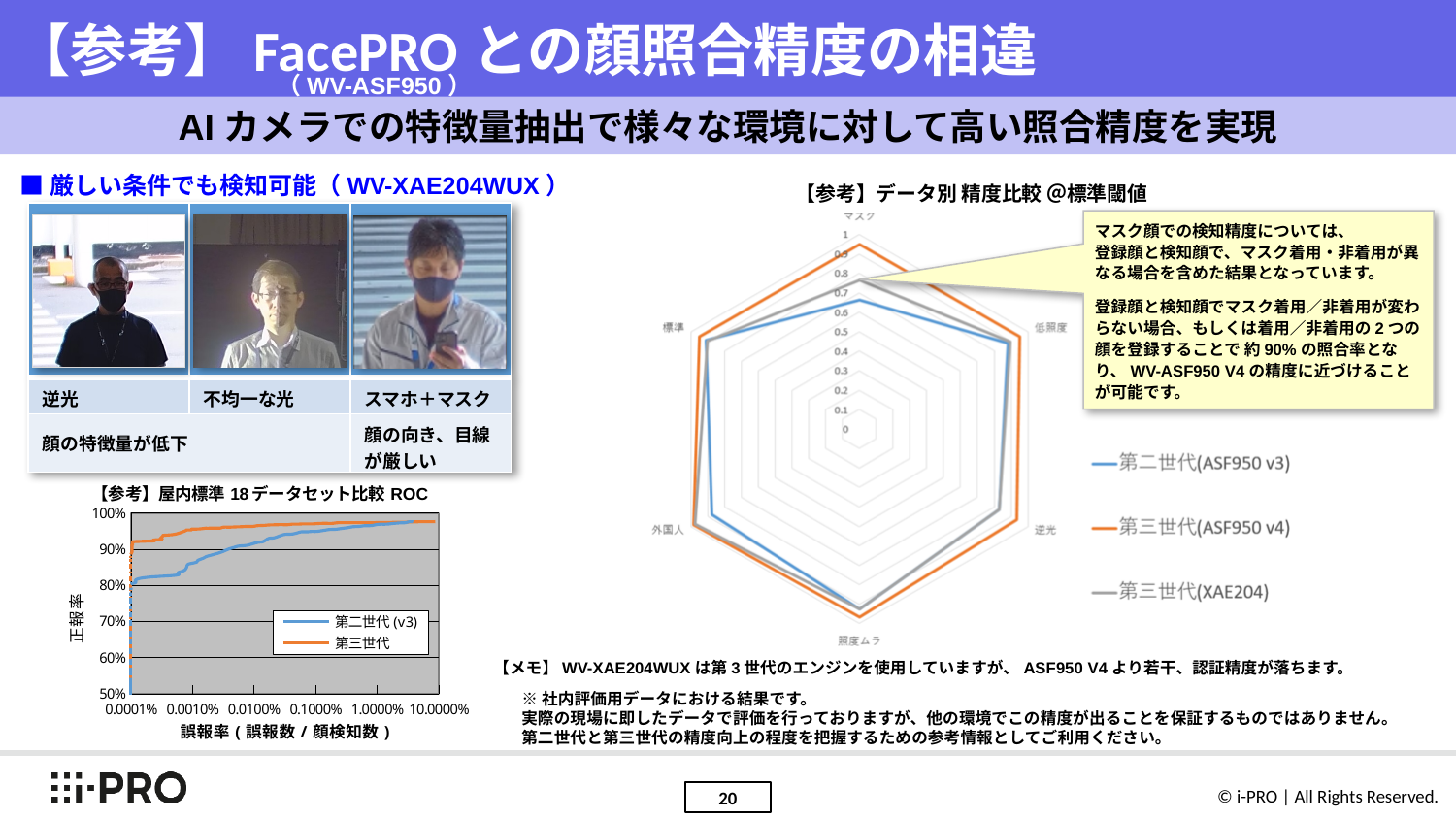
In the radar chart 【参考】データ別 精度比較 @標準閾値, which series has the highest value on the マスク axis? 第三世代(ASF950 v4) What kind of chart is the chart titled 【参考】屋内標準 18データセット比較 ROC? line chart In the radar chart 【参考】データ別 精度比較 @標準閾値, is the value of 第二世代(ASF950 v3) on the マスク axis greater or less than 0.8? less What kind of chart is the chart titled 【参考】データ別 精度比較 @標準閾値? radar chart How many axes (categories) does the radar chart 【参考】データ別 精度比較 @標準閾値 have? 6 In the radar chart 【参考】データ別 精度比較 @標準閾値, how many series does the legend list? 3 What is the label of the vertical axis in the ROC chart 【参考】屋内標準 18データセット比較 ROC? 正報率 In the ROC chart 【参考】屋内標準 18データセット比較 ROC, how many series does the legend list? 2 In the ROC chart 【参考】屋内標準 18データセット比較 ROC, which series is higher at a false-positive rate of 0.0010%: 第二世代 (v3) or 第三世代? 第三世代 In the radar chart 【参考】データ別 精度比較 @標準閾値, is the value of 第三世代(ASF950 v4) on the マスク axis greater or less than 0.8? greater In the radar chart 【参考】データ別 精度比較 @標準閾値, which series has the lowest value on the マスク axis? 第二世代(ASF950 v3) In the ROC chart 【参考】屋内標準 18データセット比較 ROC, do the values rise or fall as the false-positive rate increases along the x axis? rise